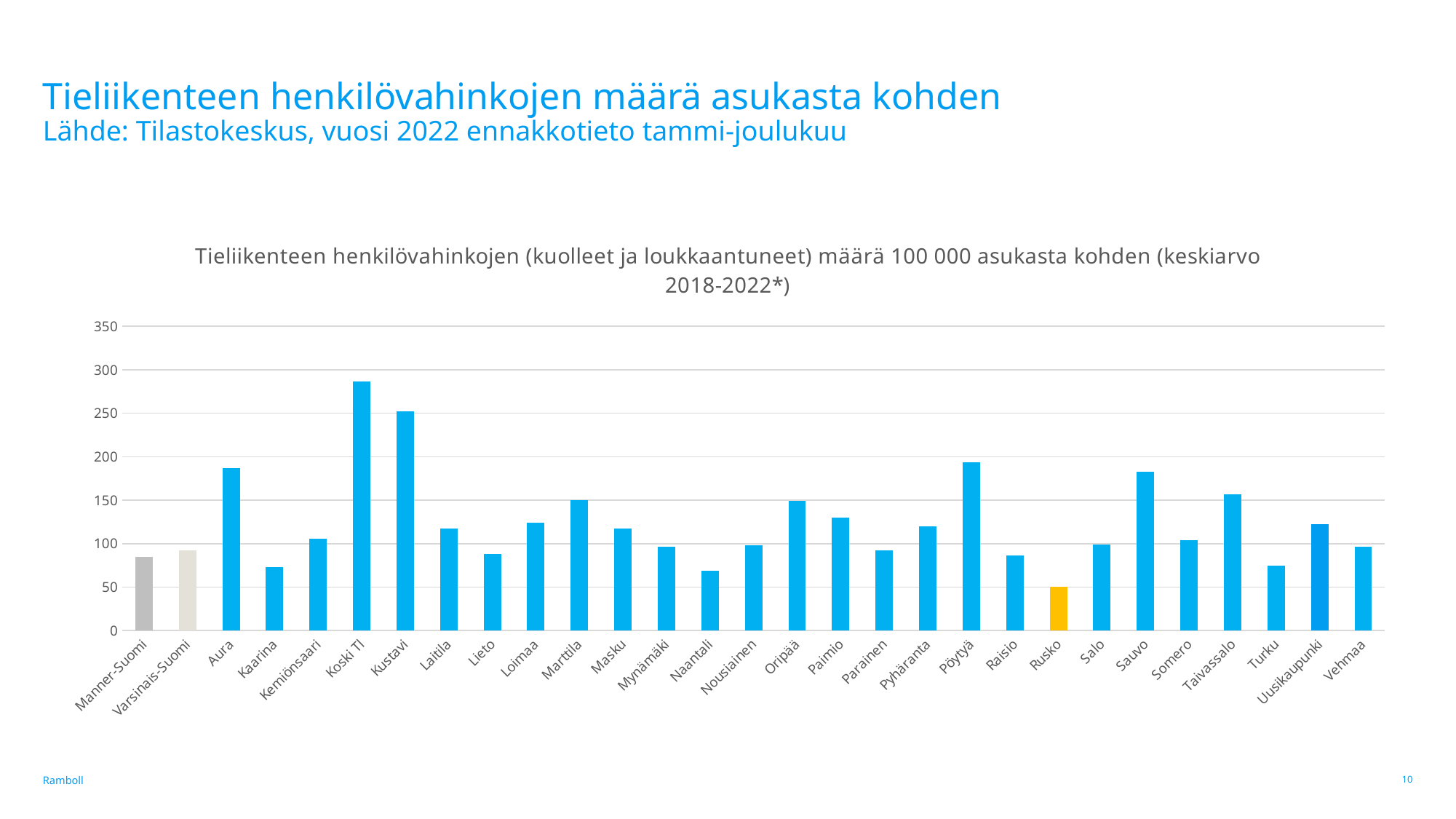
Which has the larger value, Kustavi or Sauvo? Kustavi Which bar in the chart is coloured yellow? Rusko Which category has the lowest value in the chart? Rusko Is the value for Naantali greater or less than 100? less Which has the larger value, Aura or Kaarina? Aura Is the value for Koski Tl greater or less than 250? greater Is the value for Aura greater or less than 150? greater How many categories are shown on the x axis of the chart? 29 Which category has the highest value in the chart? Koski Tl What kind of chart is shown on the slide? bar chart